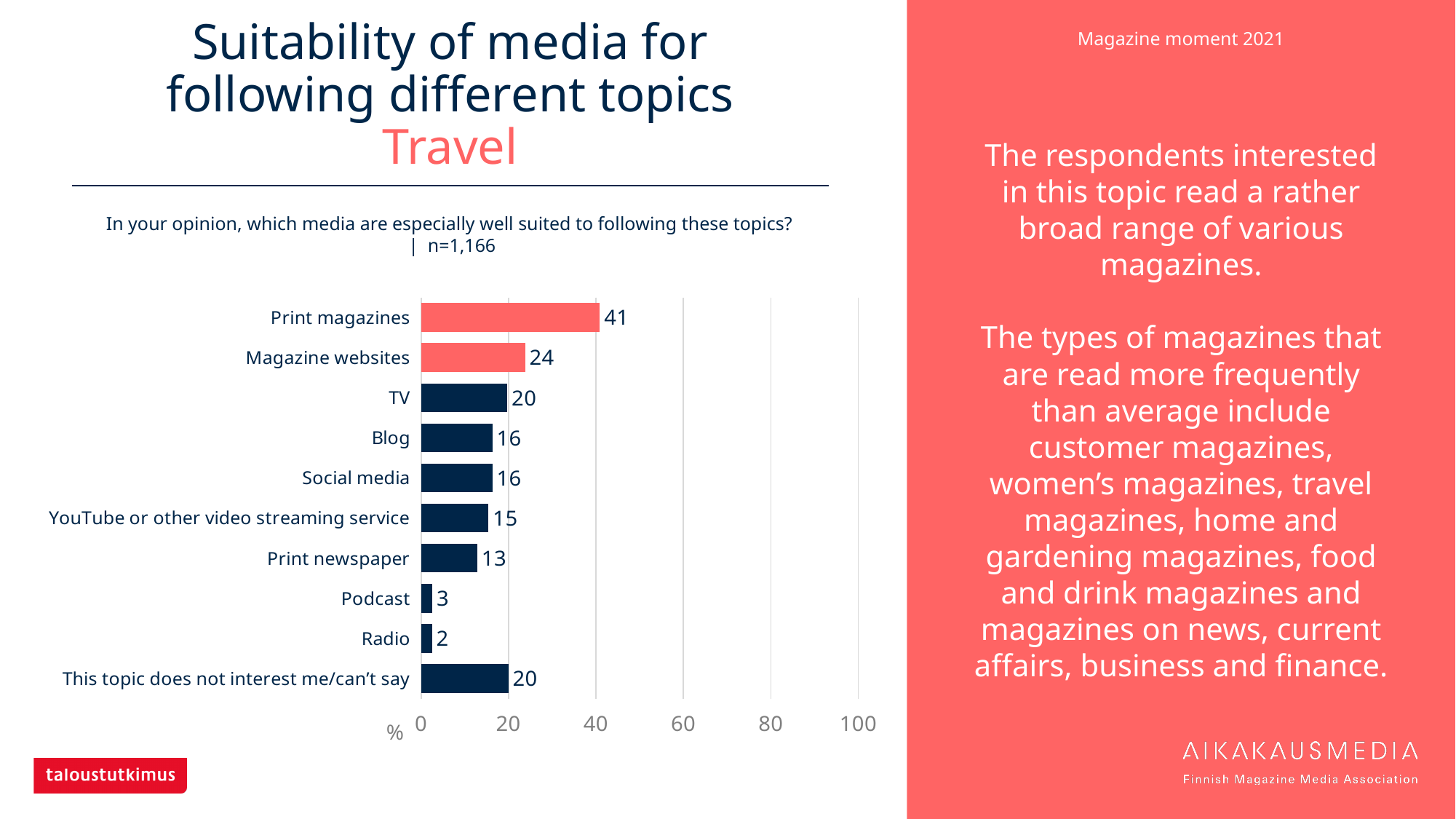
What is the value for Magazine websites? 24 What is the difference between the values for Print magazines and Magazine websites? 17 What is the value for Print newspaper? 13 Is the value for Print magazines greater or less than 40? greater How many categories are shown in the chart? 10 What is the sample size (n) stated above the chart? n=1,166 Which is larger, the value for TV or the value for Blog? TV What is the value for YouTube or other video streaming service? 15 What is the value for Print magazines? 41 Which category has the lowest value? Radio Which media category has the highest value? Print magazines What kind of chart is shown on the slide? Bar chart